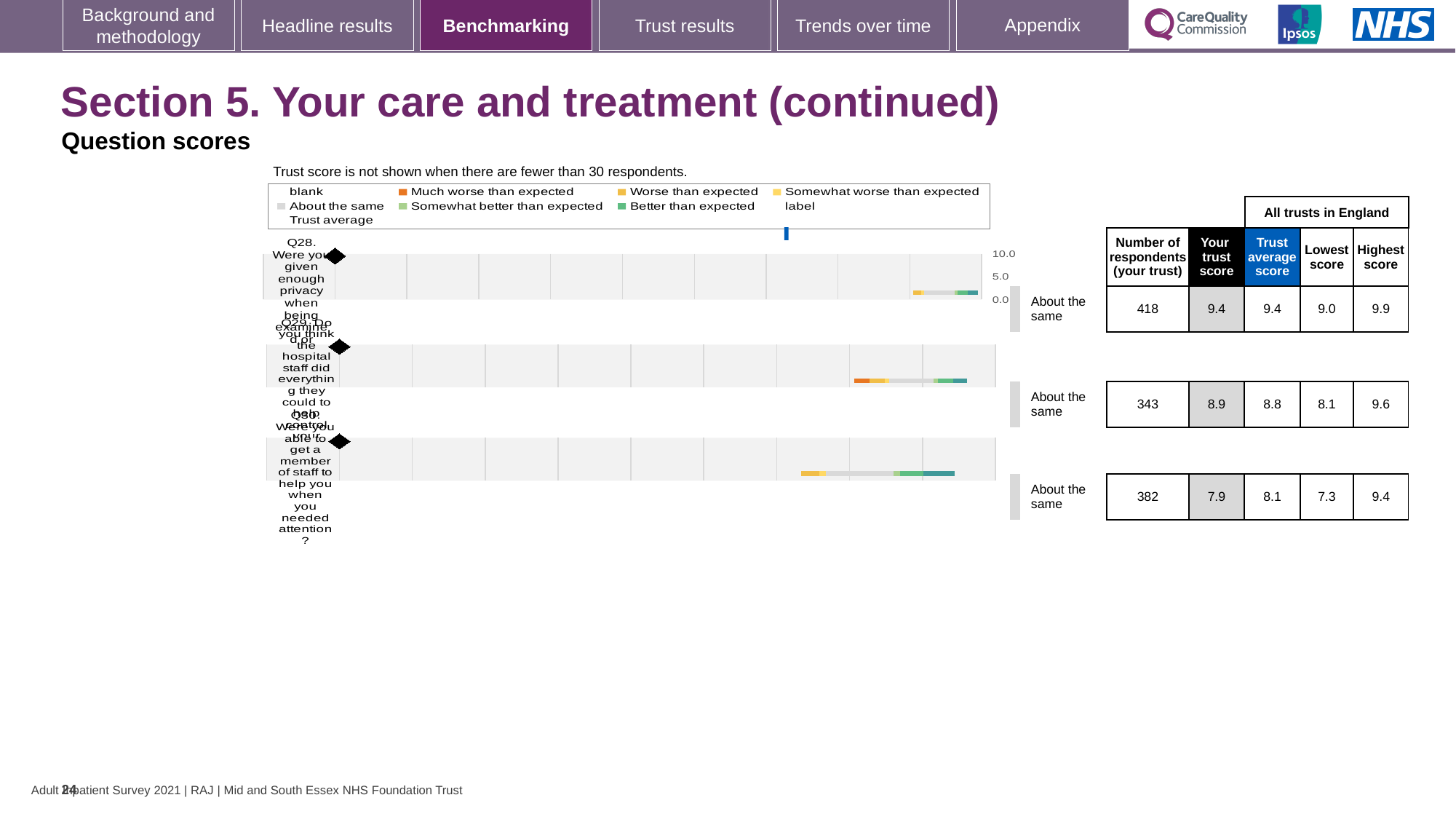
Which of the three questions shown has the highest trust score? Q28 How many respondents from the trust answered Q29? 343 What is the trust score for Q28 (Were you given enough privacy when being examined or treated)? 9.4 What is the difference between the highest score and the lowest score for Q30? 2.1 What kind of chart is used to show the question scores? Bar chart What is the lowest score across all trusts in England for Q30? 7.3 What is the trust average score for Q30? 8.1 What is the highest score across all trusts in England for Q29? 9.6 Which of the three questions shown has the lowest number of respondents? Q29 What benchmark category is shown for Q29? About the same Which is larger, the trust score for Q28 or the trust score for Q30? Q28 How many questions are plotted on this slide? 3